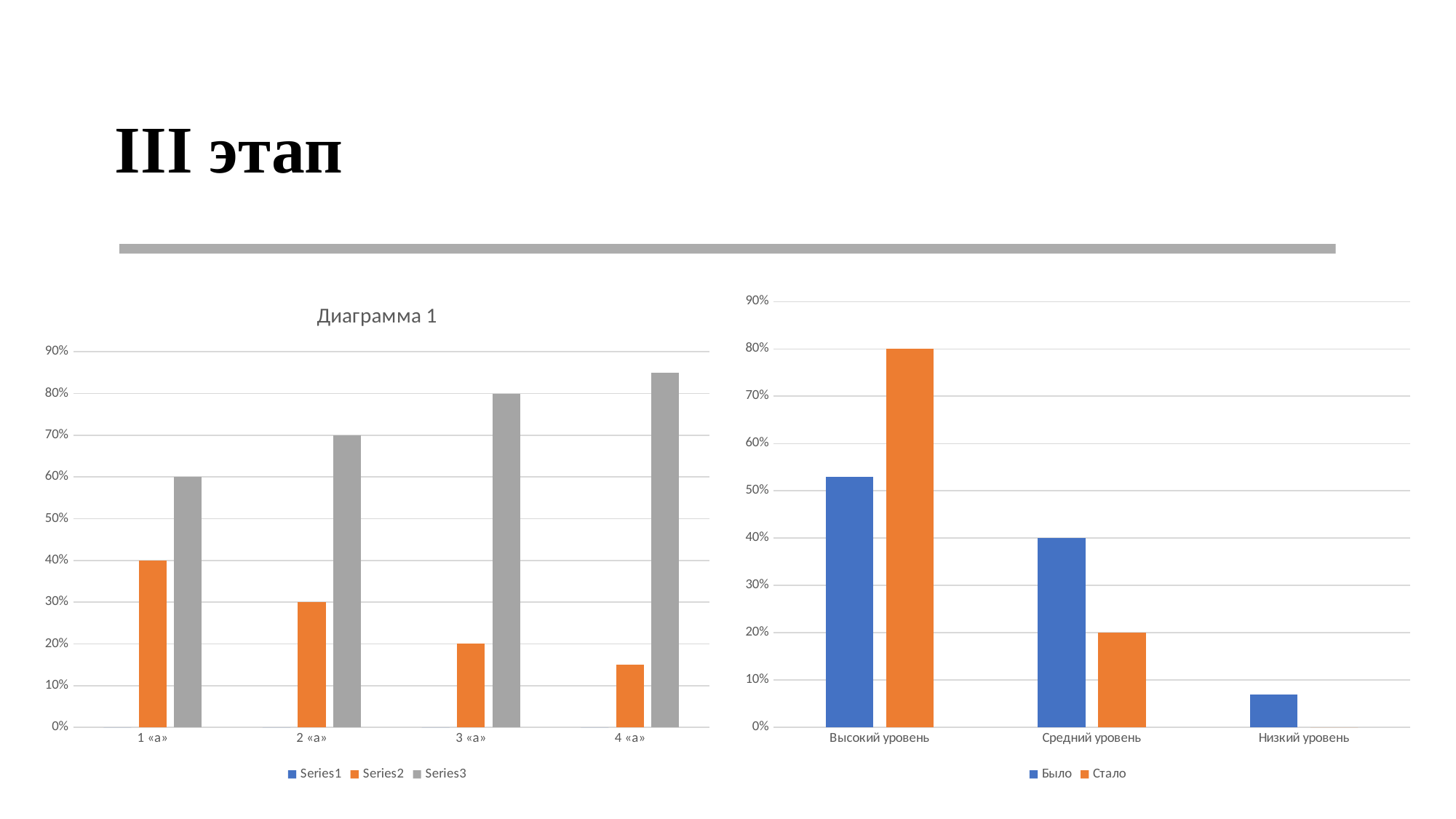
In the left chart "Диаграмма 1", how many categories are shown on the x axis? 4 In the left chart "Диаграмма 1", do the Series2 values rise or fall from 1 «а» to 4 «а»? fall In the left chart "Диаграмма 1", which category has the highest Series3 value? 4 «а» In the right chart, is the Было value for Высокий уровень greater or less than 50%? greater In the left chart "Диаграмма 1", is the Series3 value for 4 «а» greater or less than 80%? greater In the right chart, which is larger for Средний уровень, Было or Стало? Было What kind of chart is the left chart titled "Диаграмма 1"? bar chart In the right chart, what is the Стало value for Высокий уровень? 80% In the left chart "Диаграмма 1", what is the Series2 value for 1 «а»? 40% In the right chart, what is the difference between the Стало values for Высокий уровень and Средний уровень? 60% In the left chart "Диаграмма 1", what is the Series3 value for 3 «а»? 80% In the left chart "Диаграмма 1", how many series does the legend list? 3